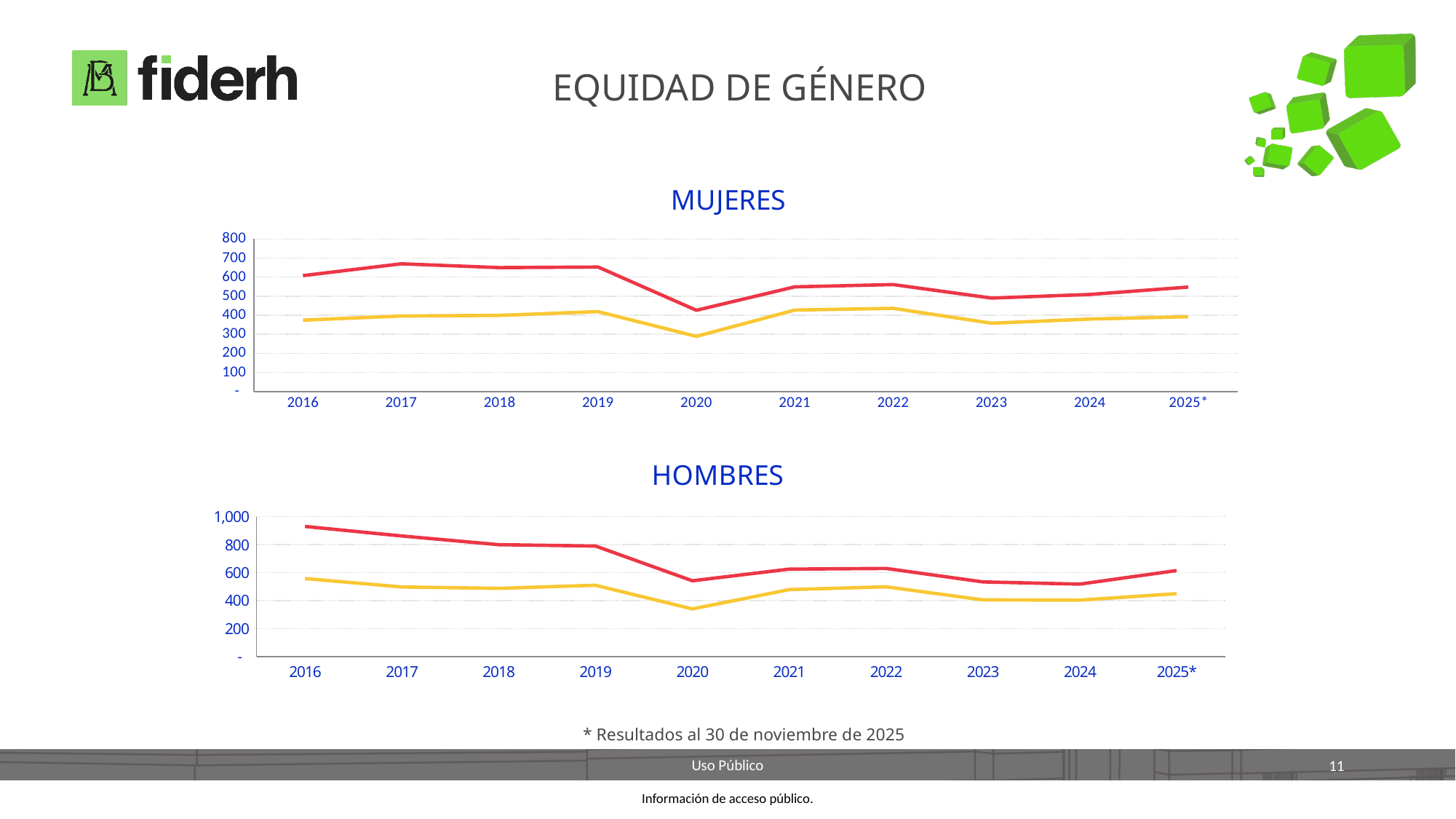
In the HOMBRES chart, which year has the larger value on the red line, 2016 or 2025*? 2016 In the MUJERES chart, in which year does the red line reach its lowest value? 2020 How many years are plotted on the x axis of the MUJERES chart? 10 In the MUJERES chart, is the value of the yellow line for 2020 greater or less than 400? less In the HOMBRES chart, is the value of the red line for 2016 greater or less than 800? greater In the HOMBRES chart, is the value of the yellow line for 2020 greater or less than 400? less What kind of chart is the MUJERES chart? line chart What is the title of the top chart on the slide? MUJERES In the HOMBRES chart, does the red line rise or fall from 2016 to 2019? fall In the HOMBRES chart, in which year does the red line reach its highest value? 2016 In the MUJERES chart, in which year does the yellow line reach its lowest value? 2020